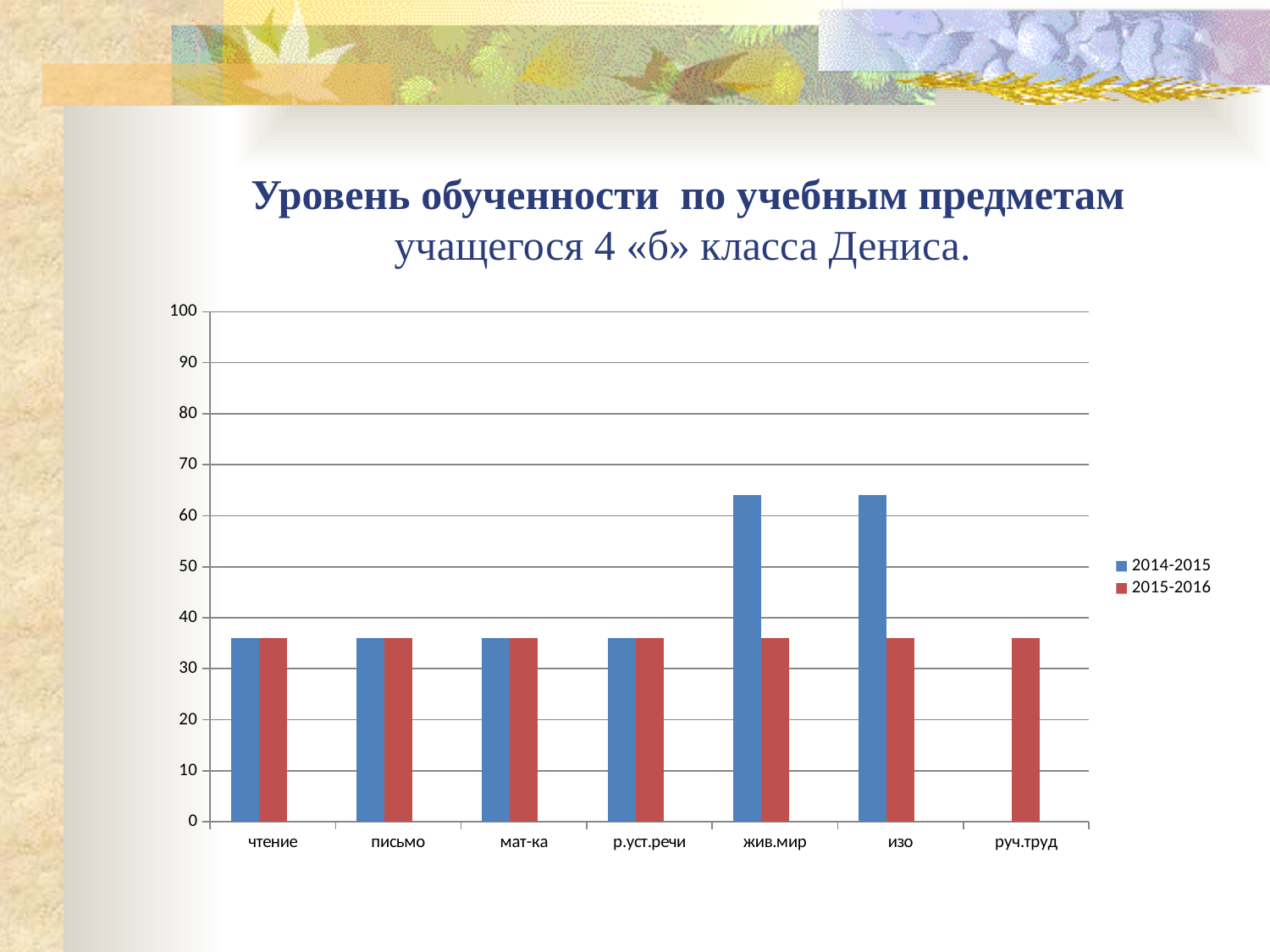
What kind of chart is shown on the slide? bar chart Is the 2015-2016 value for руч.труд greater or less than 30? greater Which series are listed in the chart's legend? 2014-2015 and 2015-2016 Is the 2014-2015 value for изо greater or less than 60? greater For жив.мир, which series has the larger value, 2014-2015 or 2015-2016? 2014-2015 How many categories are shown on the x axis of the chart? 7 Is the 2015-2016 value for изо greater or less than 40? less Which category has the highest value for the 2014-2015 series, жив.мир or письмо? жив.мир How many series does the chart's legend list? 2 Which category has no bar for the 2014-2015 series? руч.труд